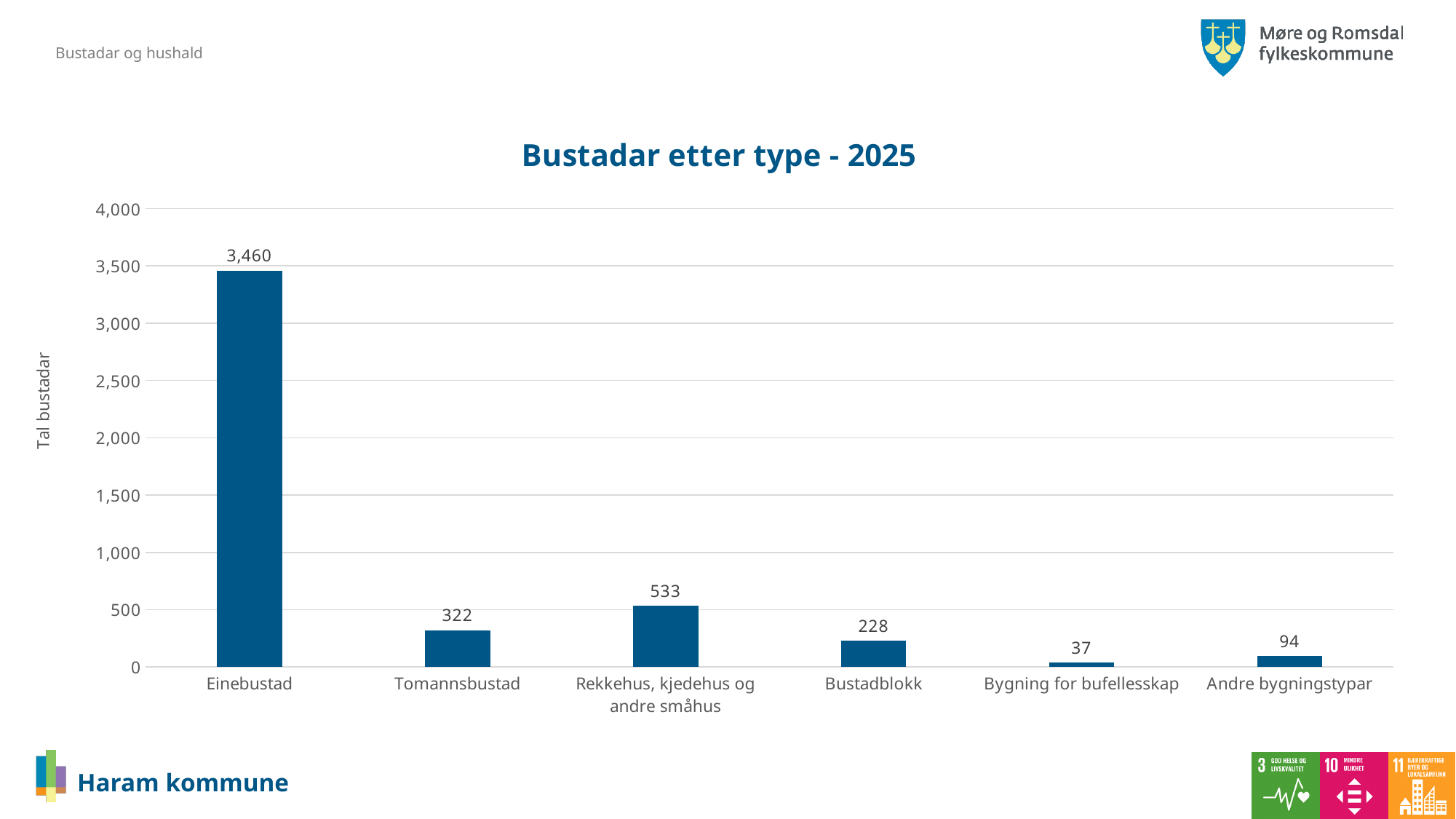
Which category has the lowest value? Bygning for bufellesskap Which is larger, the value for Bustadblokk or the value for Tomannsbustad? Tomannsbustad What is the value for Andre bygningstypar? 94 What is the difference between the values for Rekkehus, kjedehus og andre småhus and Tomannsbustad? 211 Is the value for Tomannsbustad greater or less than 500? less What kind of chart is shown on the slide? bar chart What is the value for Rekkehus, kjedehus og andre småhus? 533 What is the value for Einebustad? 3,460 Which category has the highest value? Einebustad How many categories are shown on the x axis? 6 What is the value for Bygning for bufellesskap? 37 What is the title of the chart? Bustadar etter type - 2025